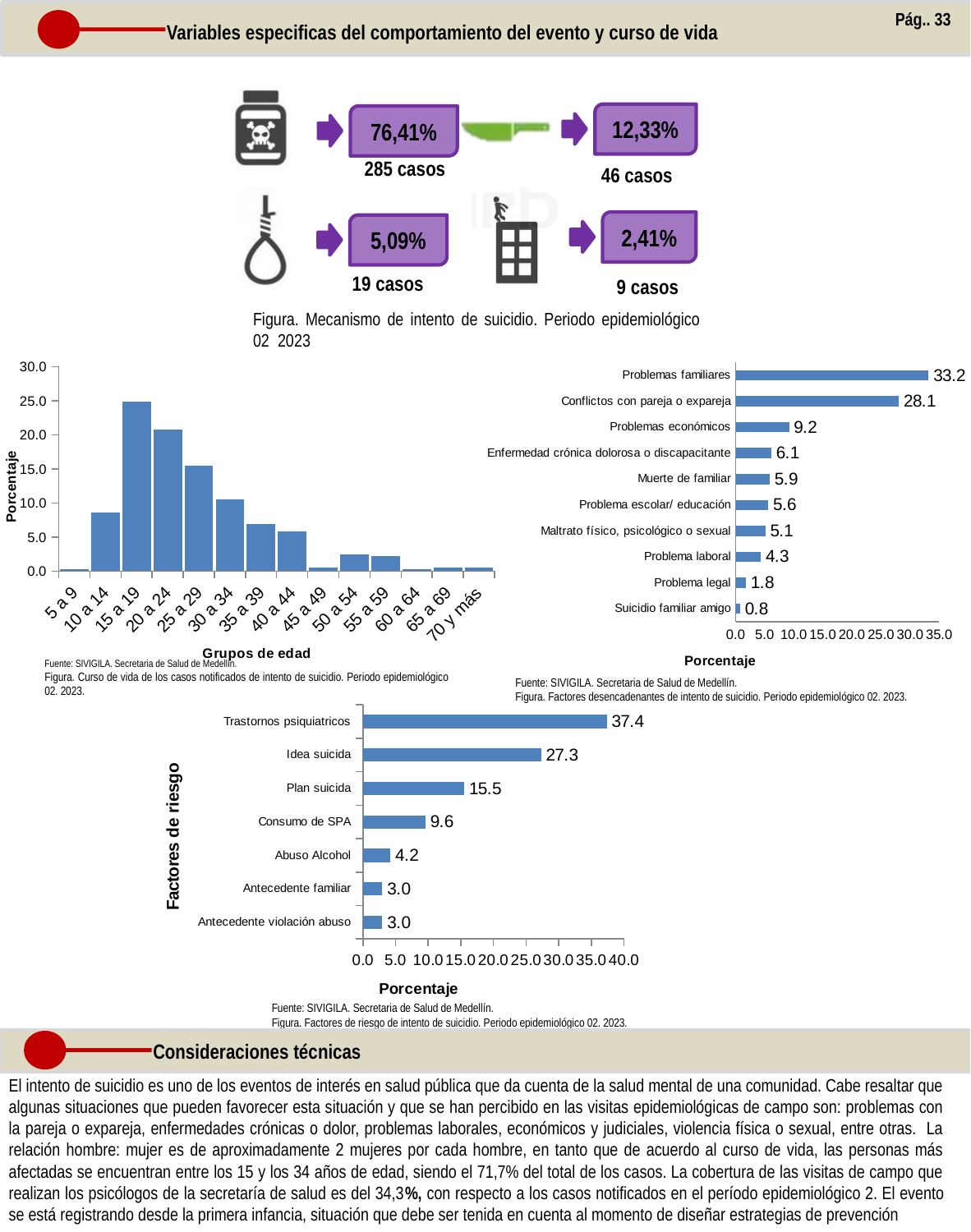
In the 'Factores de riesgo' chart (bottom), what is the difference between Trastornos psiquiatricos and Idea suicida? 10.1 In the 'Factores desencadenantes' chart (right), what is the value for Problemas familiares? 33.2 In the 'Grupos de edad' chart (left), is the value for 15 a 19 greater or less than 20.0? greater In the 'Factores desencadenantes' chart (right), how many categories are plotted? 10 In the 'Grupos de edad' chart (left), how many age groups are shown on the x axis? 14 In the 'Factores desencadenantes' chart (right), which category has the lowest value? Suicidio familiar amigo In the 'Factores desencadenantes' chart (right), what is the difference between Problemas familiares and Conflictos con pareja o expareja? 5.1 What kind of chart is the 'Grupos de edad' chart (left)? Bar chart In the 'Factores de riesgo' chart (bottom), how many categories are plotted? 7 In the 'Grupos de edad' chart (left), which age group has the highest percentage? 15 a 19 In the 'Factores de riesgo' chart (bottom), which category has the highest value? Trastornos psiquiatricos In the 'Factores de riesgo' chart (bottom), what is the value for Consumo de SPA? 9.6